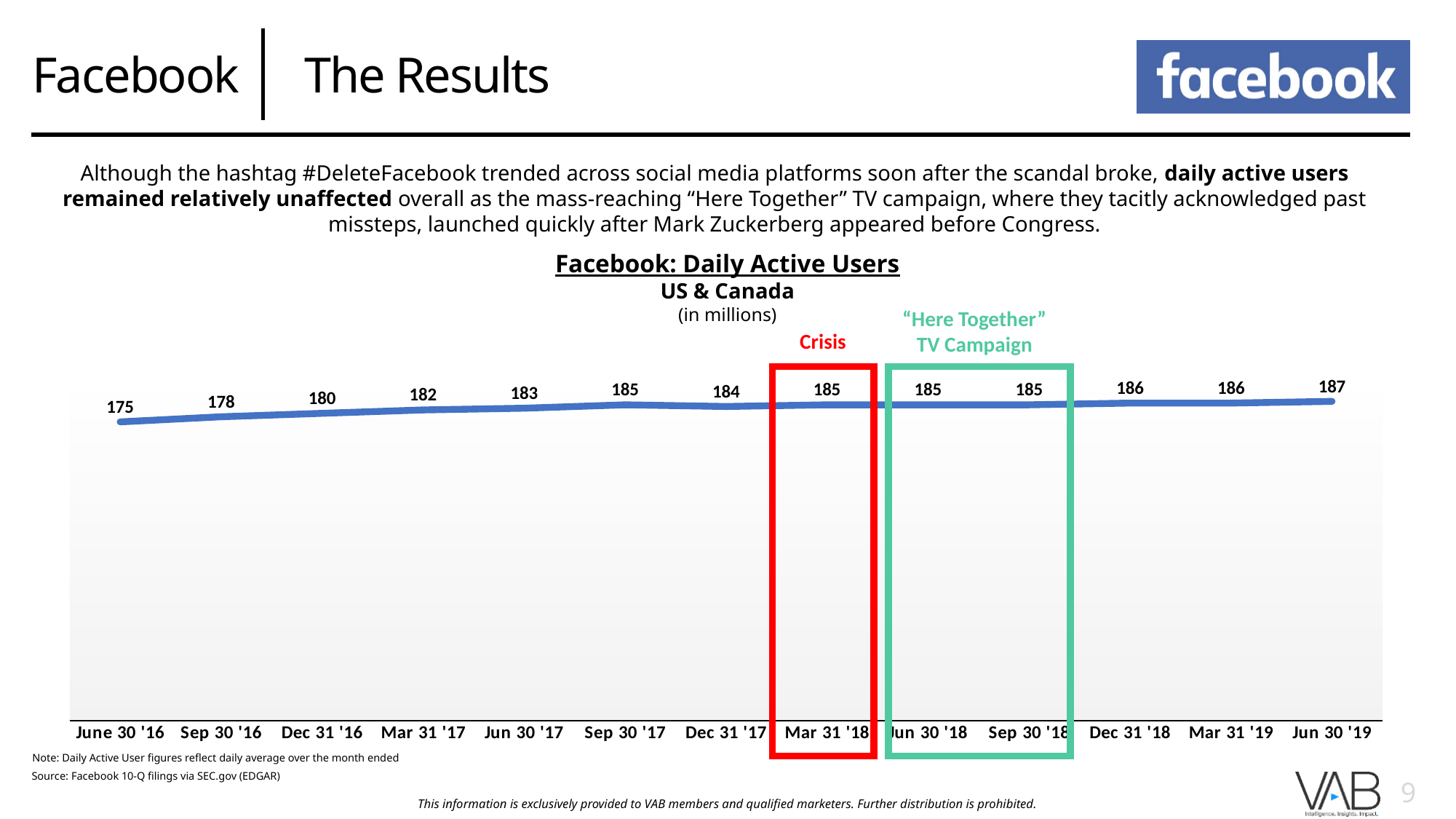
What is the value for Dec 31 '17? 184 What is the value for Mar 31 '18, the quarter marked as the Crisis? 185 Which is larger, the value for Sep 30 '17 or the value for Dec 31 '17? Sep 30 '17 Which two dates are enclosed by the green box labelled "Here Together" TV Campaign? Jun 30 '18 and Sep 30 '18 What is the value for Jun 30 '19? 187 Which date has the highest daily active users value? Jun 30 '19 What kind of chart is shown on the slide? Line chart What is the difference between the values for Jun 30 '19 and June 30 '16? 12 How many data points are plotted on the chart? 13 What is the value for June 30 '16? 175 Do the values generally rise or fall from June 30 '16 to Jun 30 '19? Rise Which date has the lowest daily active users value? June 30 '16